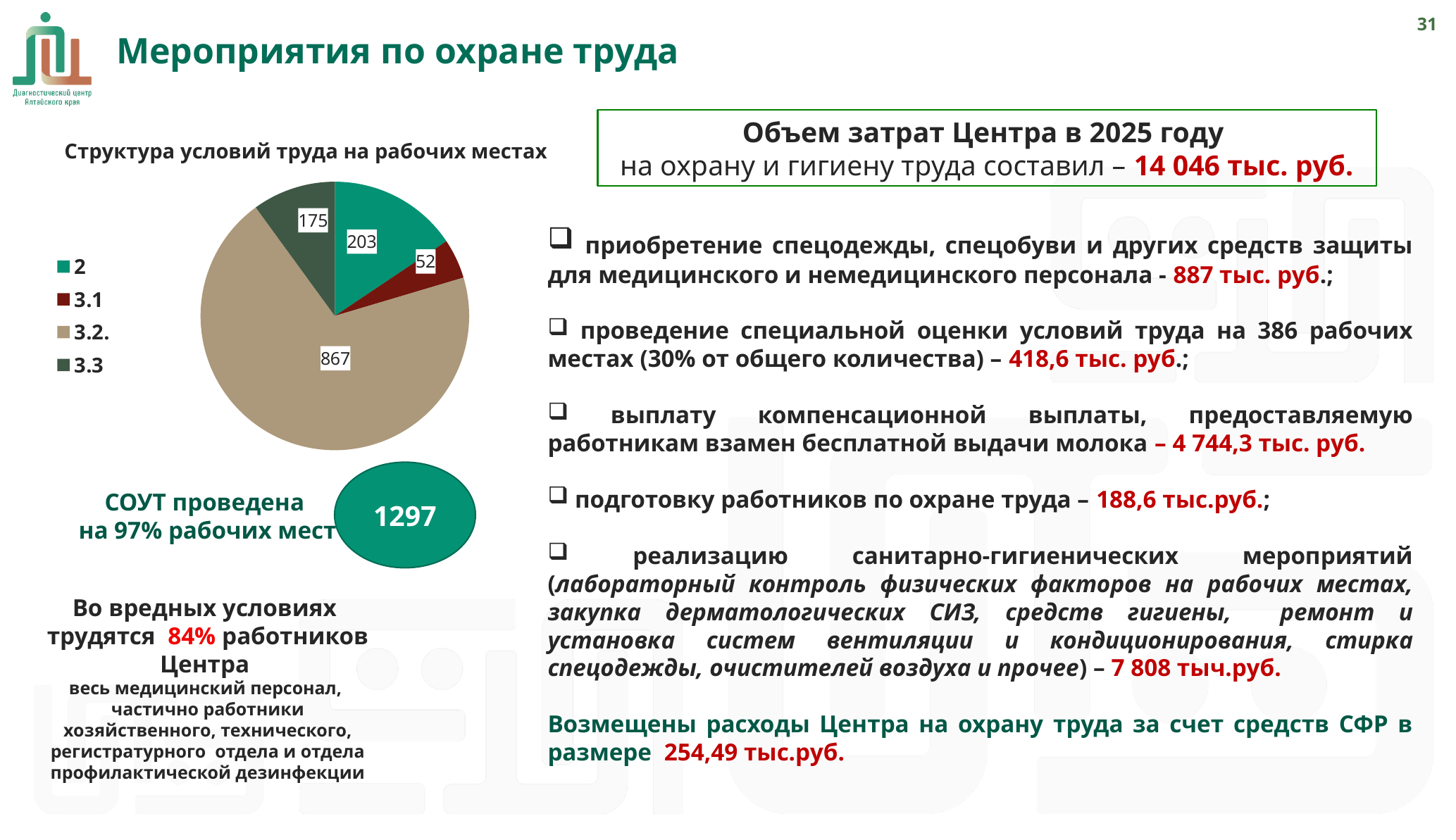
In the pie chart 'Структура условий труда на рабочих местах', what is the value for category 2? 203 In the pie chart 'Структура условий труда на рабочих местах', what is the difference between the values for categories 2 and 3.3? 28 What is the sum of all four values shown in the pie chart 'Структура условий труда на рабочих местах'? 1297 In the pie chart 'Структура условий труда на рабочих местах', what is the value for category 3.1? 52 In the pie chart 'Структура условий труда на рабочих местах', which category has the largest value? 3.2. In the pie chart 'Структура условий труда на рабочих местах', which category has the larger value: 2 or 3.3? 2 In the pie chart 'Структура условий труда на рабочих местах', what is the value for category 3.3? 175 In the pie chart 'Структура условий труда на рабочих местах', what is the value for category 3.2.? 867 In the pie chart 'Структура условий труда на рабочих местах', what is the difference between the values for categories 3.2. and 2? 664 In the pie chart 'Структура условий труда на рабочих местах', which category has the smallest value? 3.1 What type of chart is used for 'Структура условий труда на рабочих местах'? Pie chart How many categories does the pie chart 'Структура условий труда на рабочих местах' show? 4